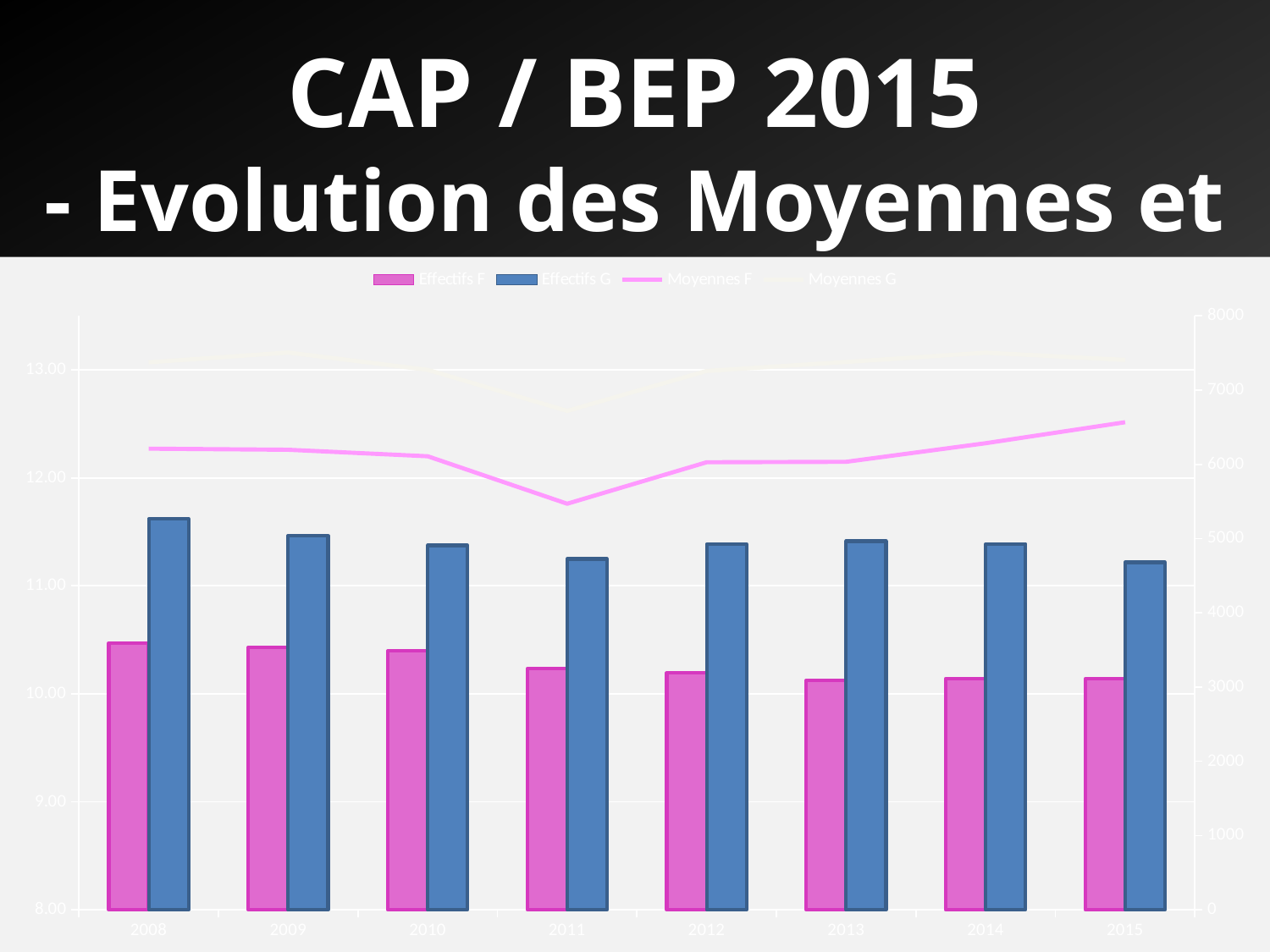
What kind of chart is shown on the slide? A combination bar and line chart How many years are shown on the x axis of the chart? 8 Does the Moyennes F line rise or fall from 2011 to 2015? It rises Is the Effectifs F value for 2015 greater or less than 4000? less Is the Effectifs G value for 2008 greater or less than 5000? greater Which year has the highest Effectifs G bar? 2008 Is the Moyennes G value for 2011 greater or less than 13.00? less In 2012, which is larger: Effectifs G or Effectifs F? Effectifs G In which year is the Moyennes F line at its highest? 2015 How many series does the chart legend list? 4 In which year is the Moyennes F line at its lowest? 2011